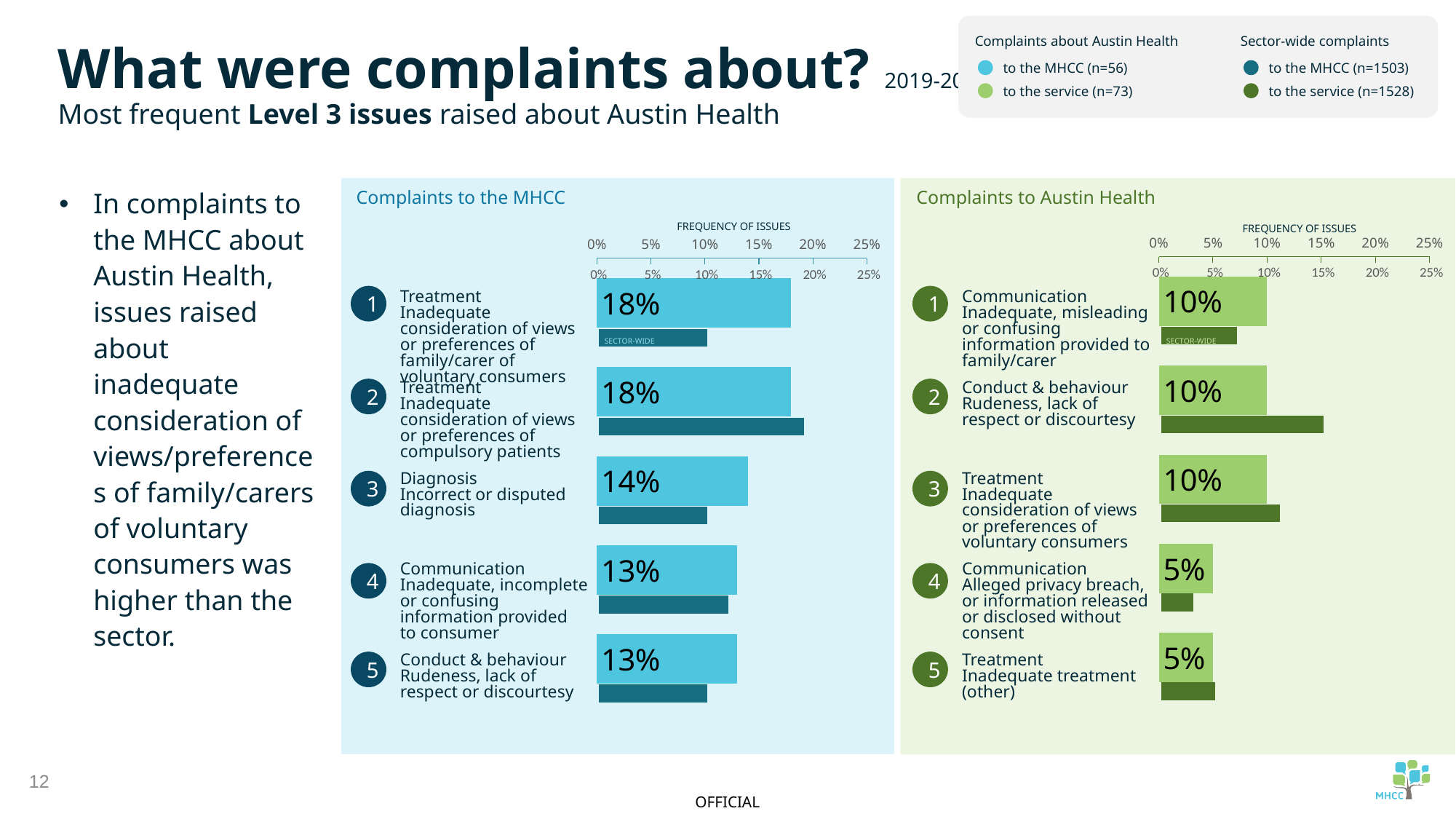
What kind of chart is used in the 'Complaints to Austin Health' panel? Bar chart In the 'Complaints to Austin Health' chart, what is the difference between the frequency for Communication (inadequate, misleading or confusing information) and Treatment (inadequate treatment, other)? 5 percentage points In the 'Complaints to Austin Health' chart, what is the frequency of issues for Communication (alleged privacy breach)? 5% In the 'Complaints to Austin Health' chart, what is the frequency of issues for Conduct & behaviour (rudeness, lack of respect or discourtesy)? 10% In the 'Complaints to Austin Health' chart, for Conduct & behaviour, which is larger: the Austin Health bar or the sector-wide bar? The sector-wide bar In the 'Complaints to the MHCC' chart, what is the frequency of issues for Conduct & behaviour (rudeness, lack of respect or discourtesy)? 13% In the 'Complaints to the MHCC' chart, is the sector-wide bar for Treatment (compulsory patients) greater or less than 15%? greater In the 'Complaints to Austin Health' chart, is the sector-wide bar for Conduct & behaviour greater or less than 10%? greater In the 'Complaints to the MHCC' chart, what is the difference between the frequency for Treatment (voluntary consumers) and Diagnosis? 4 percentage points According to the legend, how many complaints about Austin Health were made to the MHCC? n=56 In the 'Complaints to the MHCC' chart, what is the frequency of issues for Diagnosis (incorrect or disputed diagnosis)? 14% How many issues are listed in the 'Complaints to the MHCC' chart? 5